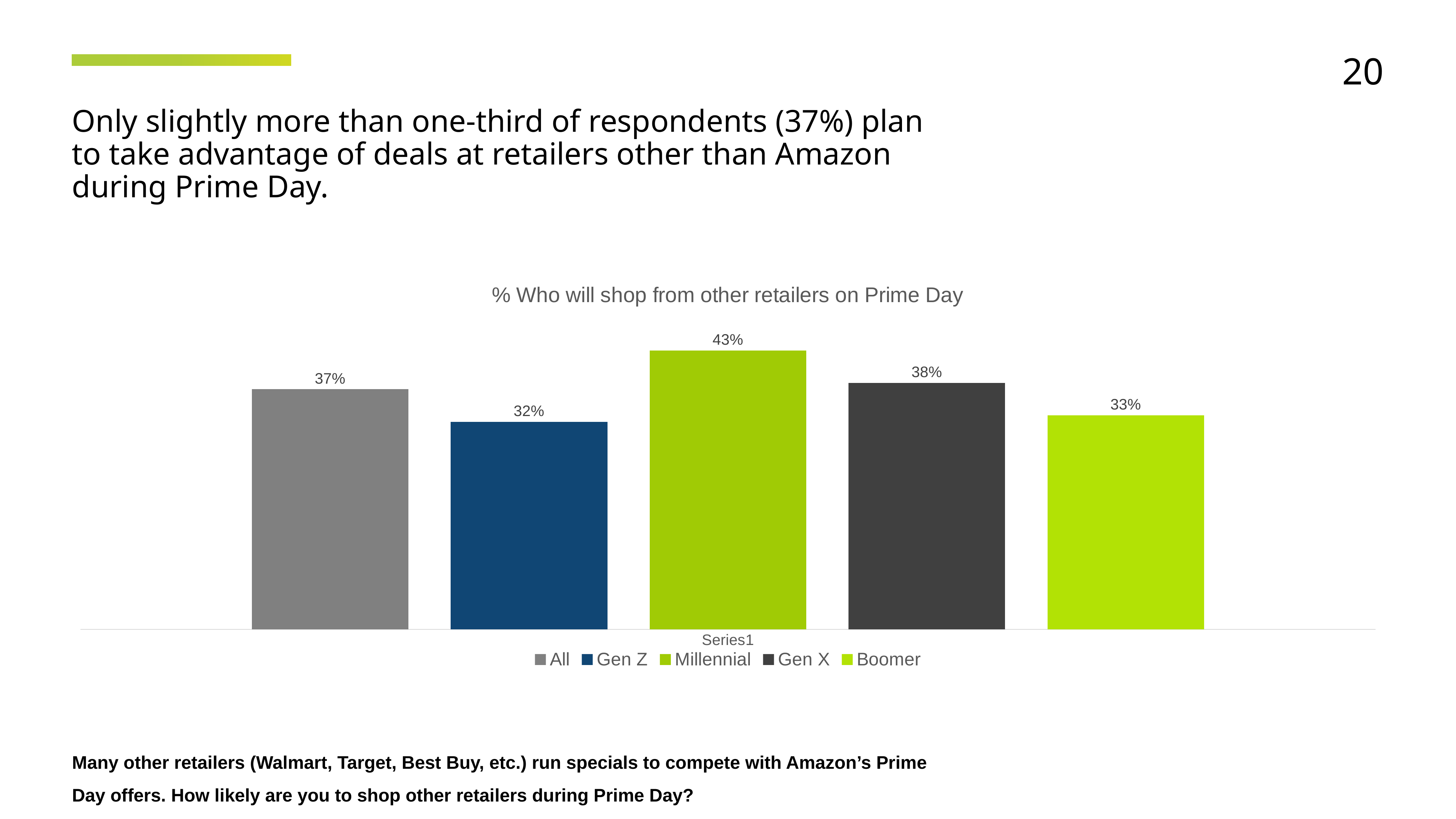
What percentage of All respondents will shop from other retailers on Prime Day? 37% What type of chart is shown on the slide? Bar chart Which is larger, the value for Gen X or the value for Gen Z? Gen X What is the difference between the Gen X and Boomer values? 5% What is the difference between the Millennial and Gen Z values? 11% How many bars are shown in the chart? 5 What is the value shown for Boomer? 33% Which group has the lowest percentage who will shop from other retailers on Prime Day? Gen Z What is the value shown for Gen Z? 32% How many entries does the legend list? 5 What is the value shown for Millennial? 43% Which group has the highest percentage who will shop from other retailers on Prime Day? Millennial